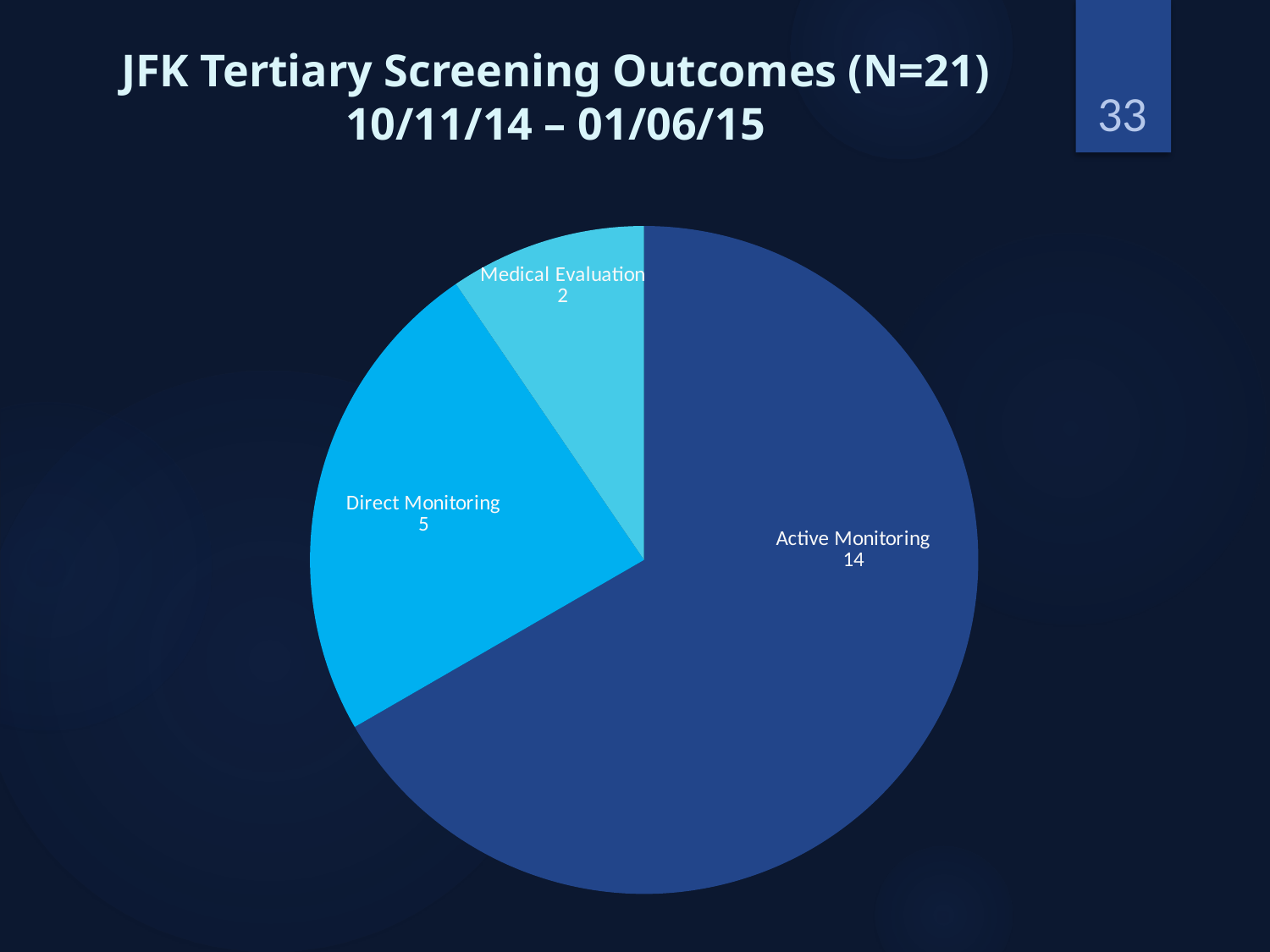
Which category has the smallest slice? Medical Evaluation What is the value for Direct Monitoring? 5 What is the difference between the values for Active Monitoring and Direct Monitoring? 9 What is the difference between the values for Direct Monitoring and Medical Evaluation? 3 How many categories are shown in the pie chart? 3 What type of chart is shown on the slide? pie chart What is the value for Medical Evaluation? 2 Which is larger, Direct Monitoring or Medical Evaluation? Direct Monitoring What is the value for Active Monitoring? 14 Which category has the largest slice? Active Monitoring What is the title of the chart? JFK Tertiary Screening Outcomes (N=21) 10/11/14 – 01/06/15